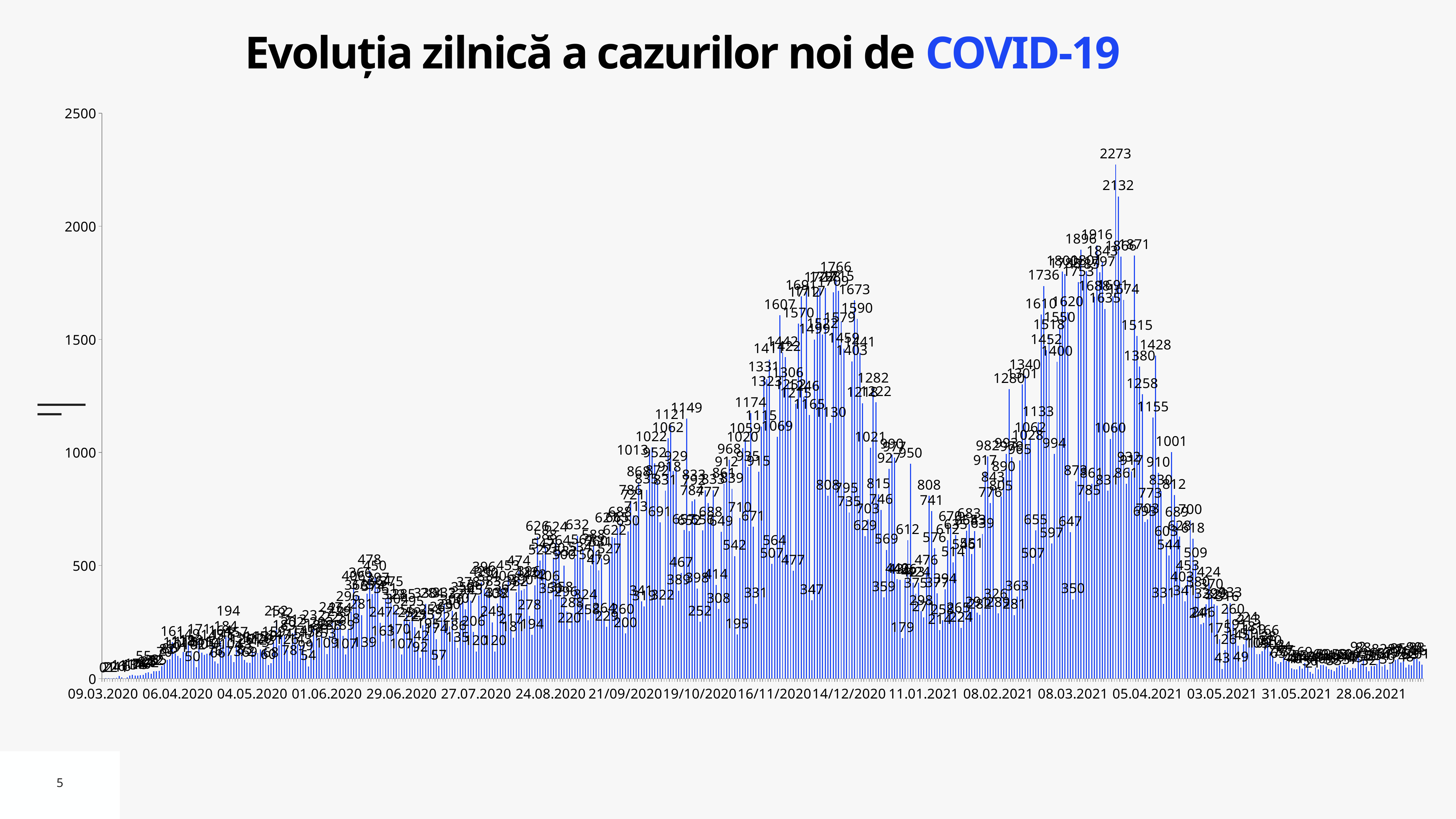
What kind of chart is shown on the slide? bar chart What is the highest value labelled in the wave around 14/12/2020? 1766 What is the highest daily value labelled on the chart? 2273 Do the values rise or fall between 05.04.2021 and 31.05.2021? fall How many date labels are shown on the x axis? 18 Is the highest bar on the chart greater or less than 2000? greater What is the title of the chart? Evoluția zilnică a cazurilor noi de COVID-19 Which is higher: the peak of the wave around 14/12/2020 or the peak of the wave around 05.04.2021? the peak around 05.04.2021 What is the difference between the two highest labelled values, 2273 and 2132? 141 What is the maximum value shown on the y axis? 2500 What is the second-highest value labelled on the chart, next to the 2273 peak? 2132 Are the daily values around 09.03.2020 greater or less than 500? less